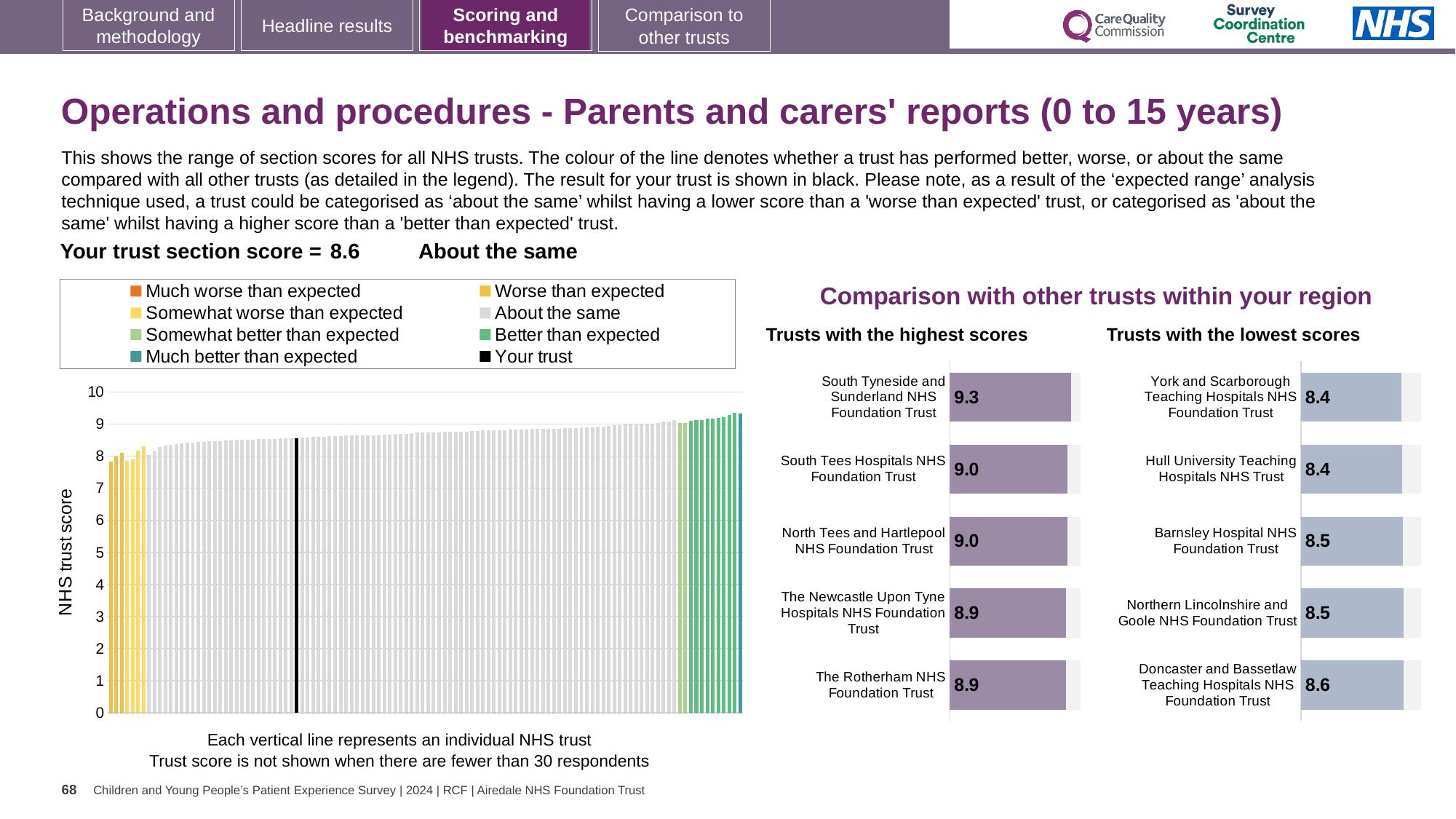
In the 'Trusts with the lowest scores' chart, what is the score for Barnsley Hospital NHS Foundation Trust? 8.5 In the 'Trusts with the lowest scores' chart, which trust has the highest score shown? Doncaster and Bassetlaw Teaching Hospitals NHS Foundation Trust In the 'Trusts with the highest scores' chart, which trust has the highest score? South Tyneside and Sunderland NHS Foundation Trust What kind of chart is the large chart on the left showing NHS trust scores? bar chart In the 'Trusts with the lowest scores' chart, what is the difference between the scores of Doncaster and Bassetlaw Teaching Hospitals NHS Foundation Trust and Hull University Teaching Hospitals NHS Trust? 0.2 In the 'Trusts with the highest scores' chart, what is the difference between the scores of South Tyneside and Sunderland NHS Foundation Trust and The Rotherham NHS Foundation Trust? 0.4 In the 'Trusts with the highest scores' chart, which has the larger score: South Tees Hospitals NHS Foundation Trust or The Newcastle Upon Tyne Hospitals NHS Foundation Trust? South Tees Hospitals NHS Foundation Trust How many entries does the legend above the large chart on the left list? 8 In the large chart on the left, do the trust scores rise or fall from left to right along the x axis? rise How many trusts are listed in the 'Trusts with the lowest scores' chart? 5 In the 'Trusts with the highest scores' chart, what is the score for South Tyneside and Sunderland NHS Foundation Trust? 9.3 In the large chart on the left, is the value for the black bar (your trust) greater or less than 8? greater